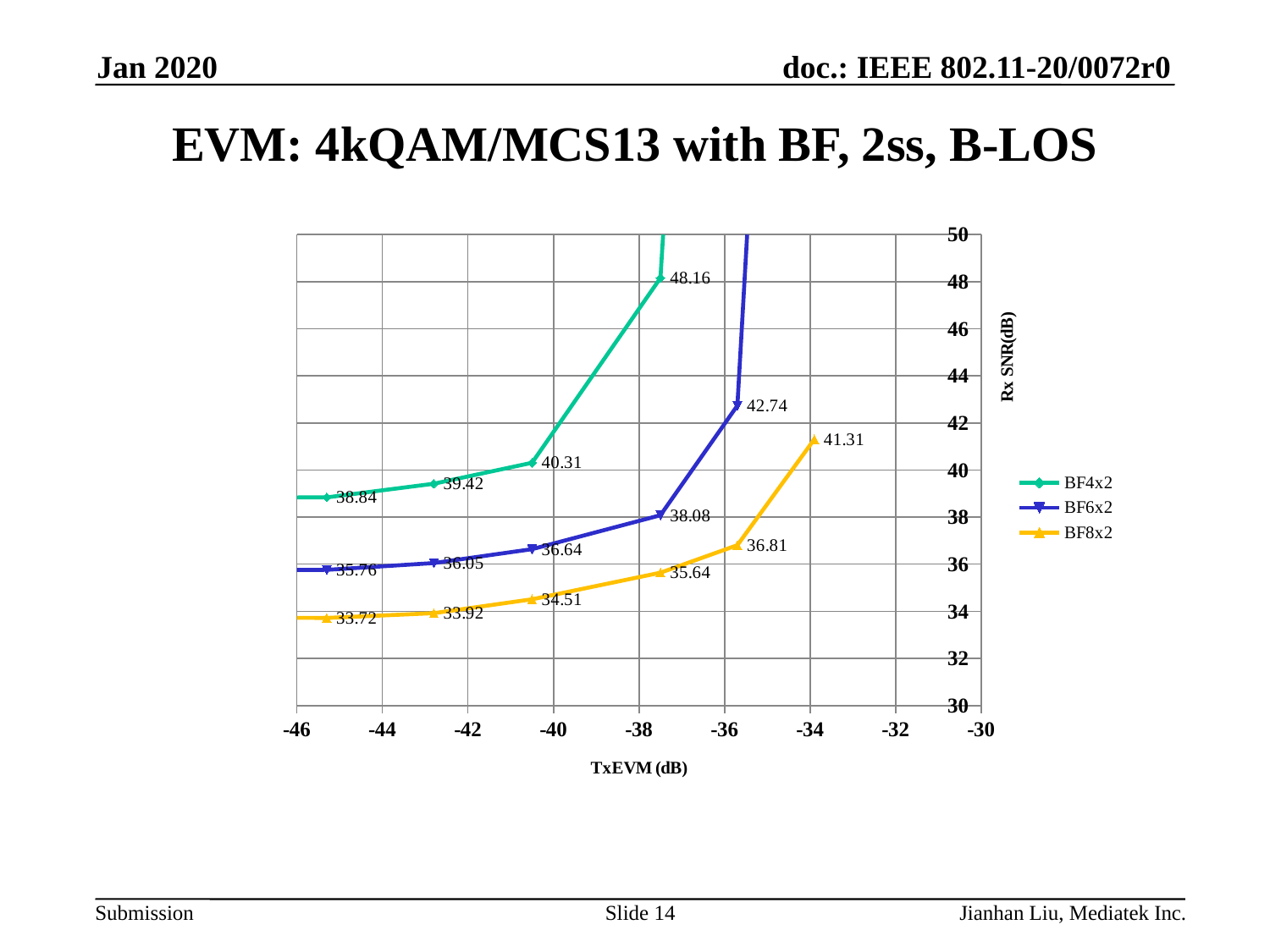
How many labeled data points are there on the BF8x2 series? 6 What are the series names listed in the legend? BF4x2, BF6x2, BF8x2 What kind of chart is shown on the slide? line chart What is the lowest labeled Rx SNR value on the BF6x2 series? 35.76 What is the lowest labeled Rx SNR value on the BF8x2 series? 33.72 How many series does the legend list? 3 As TxEVM increases along the x axis, do the Rx SNR values rise or fall? rise What is the difference between the two highest labeled values on the BF8x2 series (41.31 and 36.81)? 4.50 What is the highest labeled Rx SNR value on the BF6x2 series? 42.74 At the leftmost labeled point, which series has the larger Rx SNR value, BF4x2 or BF8x2? BF4x2 What is the difference between the highest labeled value (48.16) and the second-highest labeled value (40.31) on the BF4x2 series? 7.85 What is the highest labeled Rx SNR value on the BF4x2 series? 48.16